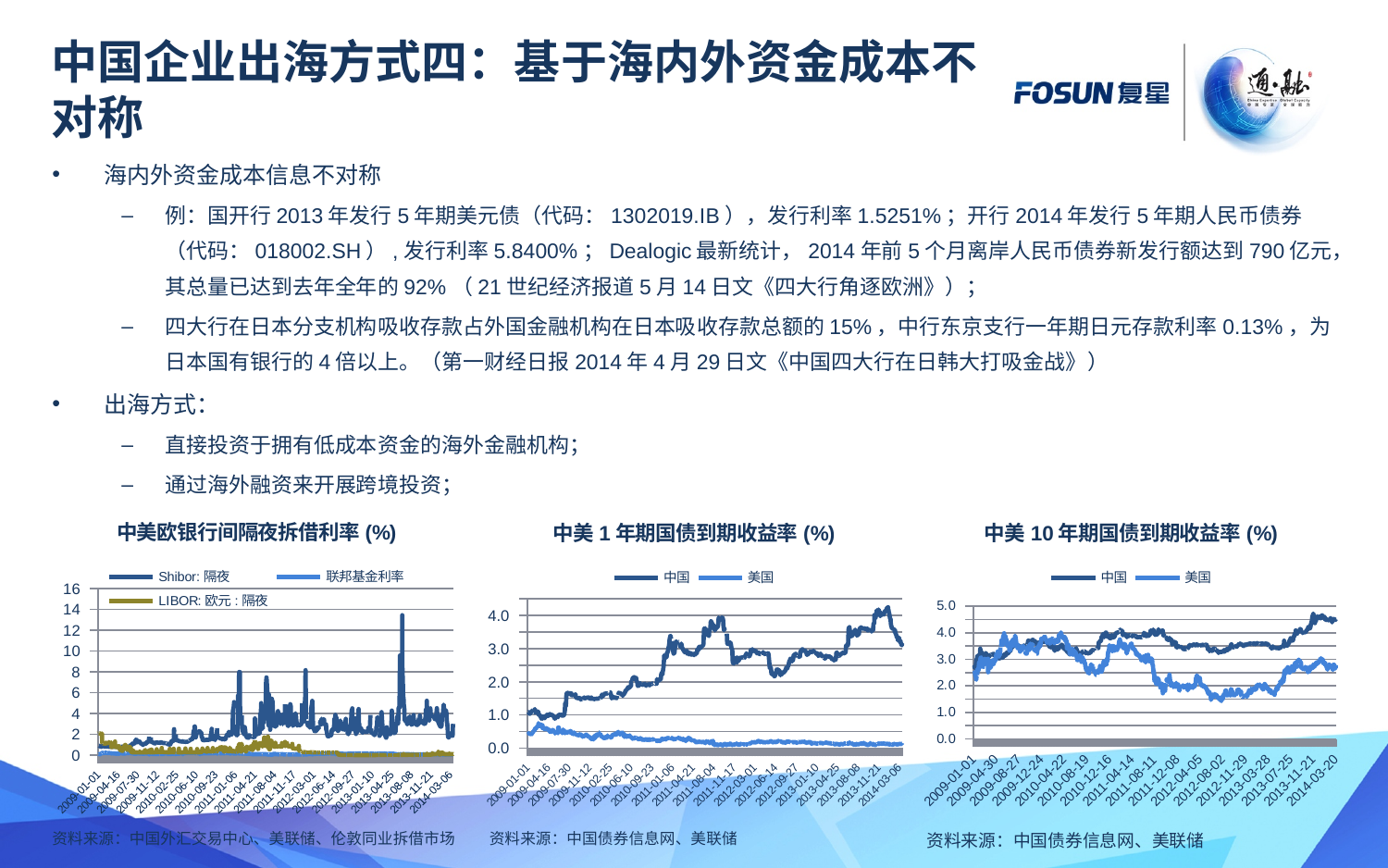
In the chart titled 中美 10 年期国债到期收益率 (%), is the 美国 series greater or less than 3.0 at the end of the period? less What are the two legend entries of the chart titled 中美 10 年期国债到期收益率 (%)? 中国, 美国 In the chart titled 中美欧银行间隔夜拆借利率 (%), which series reaches the highest peak? Shibor: 隔夜 In the chart titled 中美欧银行间隔夜拆借利率 (%), is the 联邦基金利率 series greater or less than 2 throughout the period? less In the chart titled 中美 1 年期国债到期收益率 (%), does the 中国 series rise or fall overall from 2009 to 2014? rise What kind of chart is the chart titled 中美欧银行间隔夜拆借利率 (%)? line chart In the chart titled 中美欧银行间隔夜拆借利率 (%), is the highest peak of the Shibor: 隔夜 series greater or less than 10? greater In the chart titled 中美 1 年期国债到期收益率 (%), which series is higher at the end of the period, 中国 or 美国? 中国 How many series does the legend of the chart titled 中美欧银行间隔夜拆借利率 (%) list? 3 How many series does the legend of the chart titled 中美 1 年期国债到期收益率 (%) list? 2 What kind of chart is the chart titled 中美 10 年期国债到期收益率 (%)? line chart